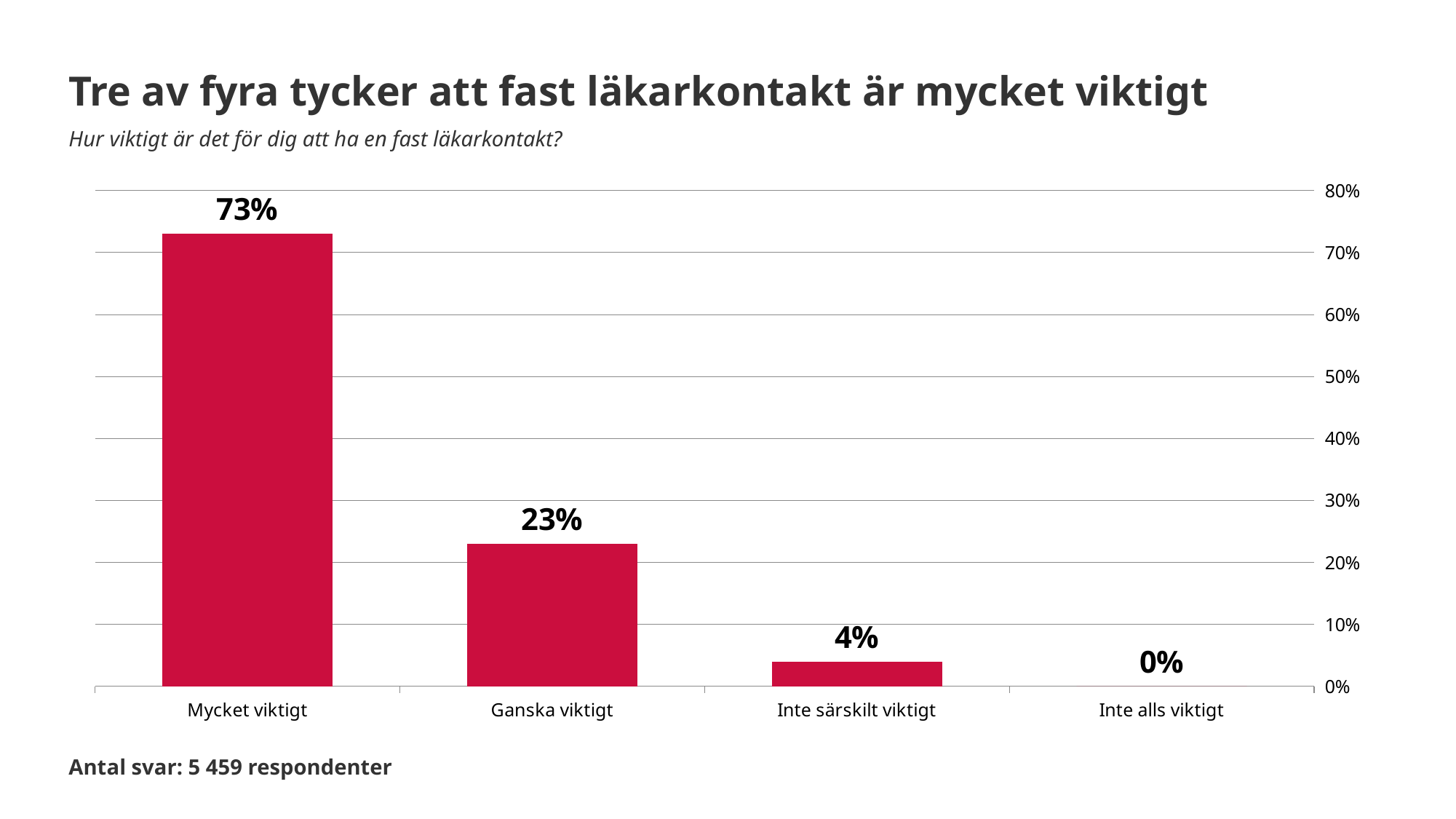
What is the difference between the values for Mycket viktigt and Ganska viktigt? 50% Which category has the highest value? Mycket viktigt Which category has the lowest value? Inte alls viktigt What is the value for Inte särskilt viktigt? 4% What is the value for Ganska viktigt? 23% What is the value for Mycket viktigt? 73% What kind of chart is shown on the slide? bar chart How many categories are shown on the x axis? 4 What is the value for Inte alls viktigt? 0% Is the value for Mycket viktigt greater or less than 70%? greater Do the values rise or fall from left to right along the x axis? fall Which is larger, the value for Ganska viktigt or the value for Inte särskilt viktigt? Ganska viktigt